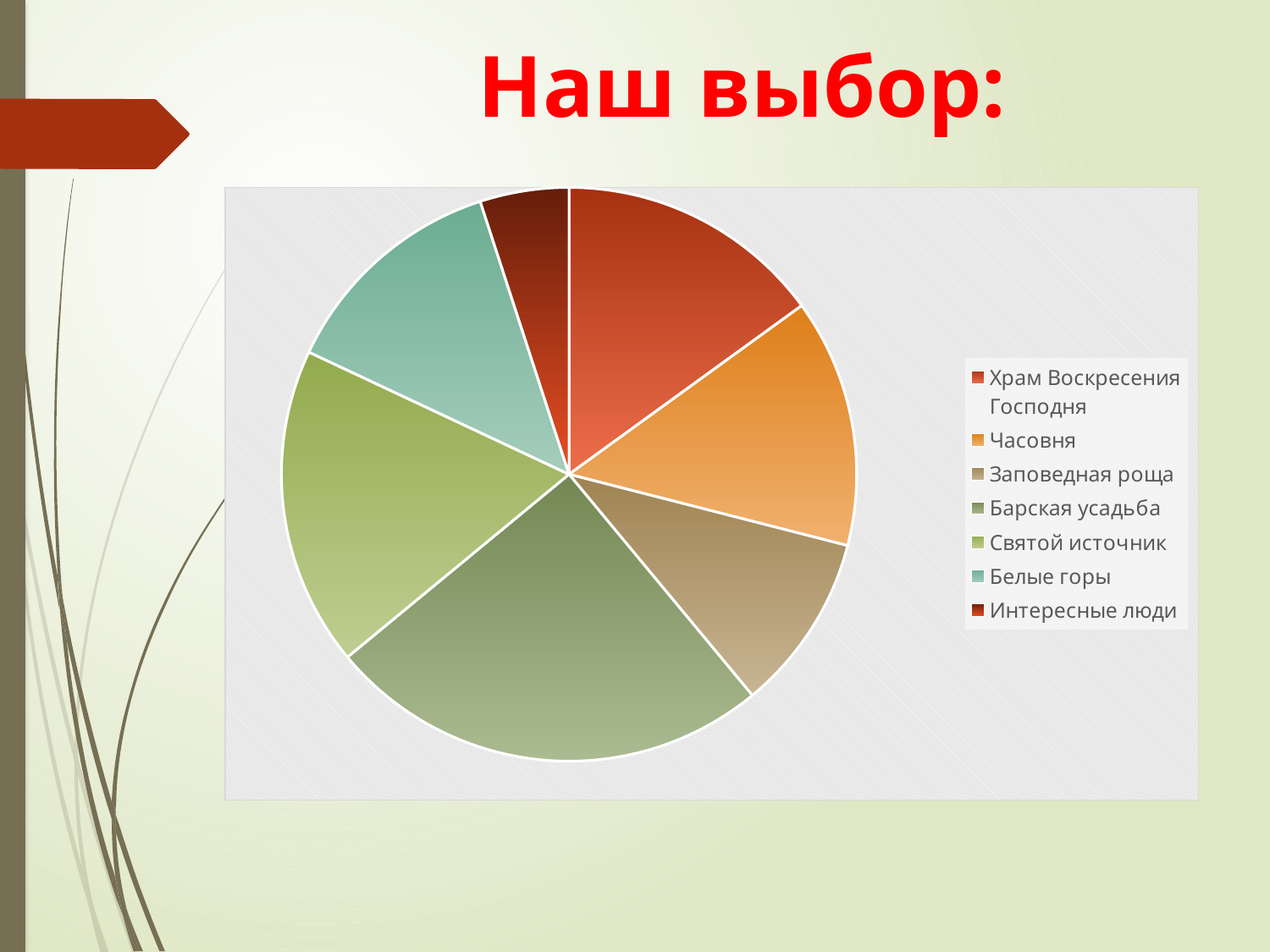
Which slice is larger: Барская усадьба or Заповедная роща? Барская усадьба Which slice is larger: Храм Воскресения Господня or Интересные люди? Храм Воскресения Господня Which category is shown in orange in the pie chart? Часовня Which slice is larger: Святой источник or Заповедная роща? Святой источник How many slices does the pie chart have? 7 What kind of chart is shown on the slide? pie chart What is the title of the slide containing the pie chart? Наш выбор: How many entries does the legend of the pie chart list? 7 Which category has the smallest slice in the pie chart? Интересные люди Which category has the largest slice in the pie chart? Барская усадьба